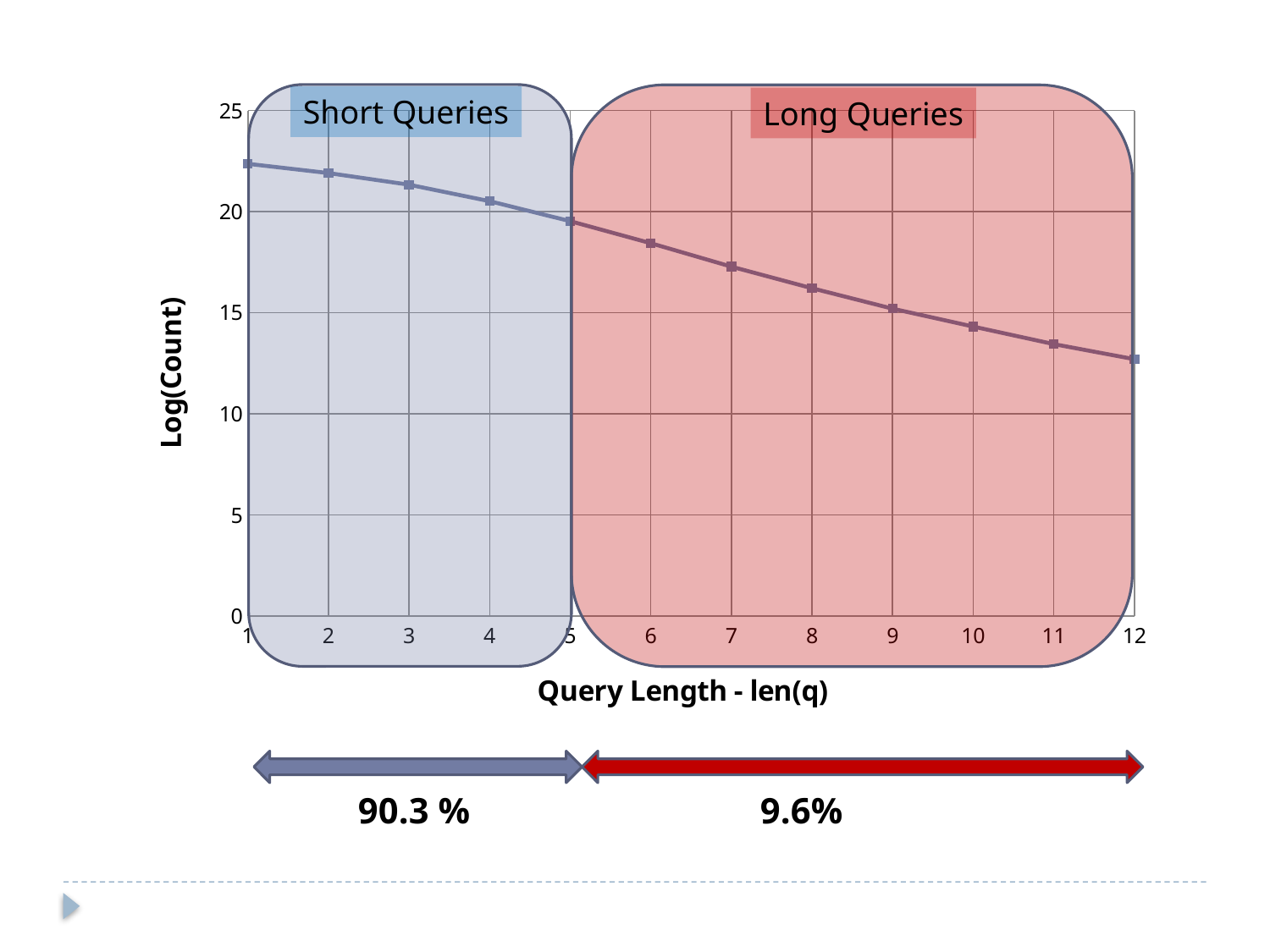
Is the Log(Count) value for query length 12 greater or less than 15? less Which has a larger Log(Count) value, query length 3 or query length 9? query length 3 How many data points are plotted on the line? 12 Is the Log(Count) value for query length 6 greater or less than 20? less What percentage is shown under the Long Queries region? 9.6% Do the Log(Count) values rise or fall as query length increases along the x axis? fall Is the Log(Count) value for query length 1 greater or less than 20? greater At which query length is Log(Count) lowest? 12 What is the label of the y axis? Log(Count) What kind of chart is shown on the slide? line chart At which query length is Log(Count) highest? 1